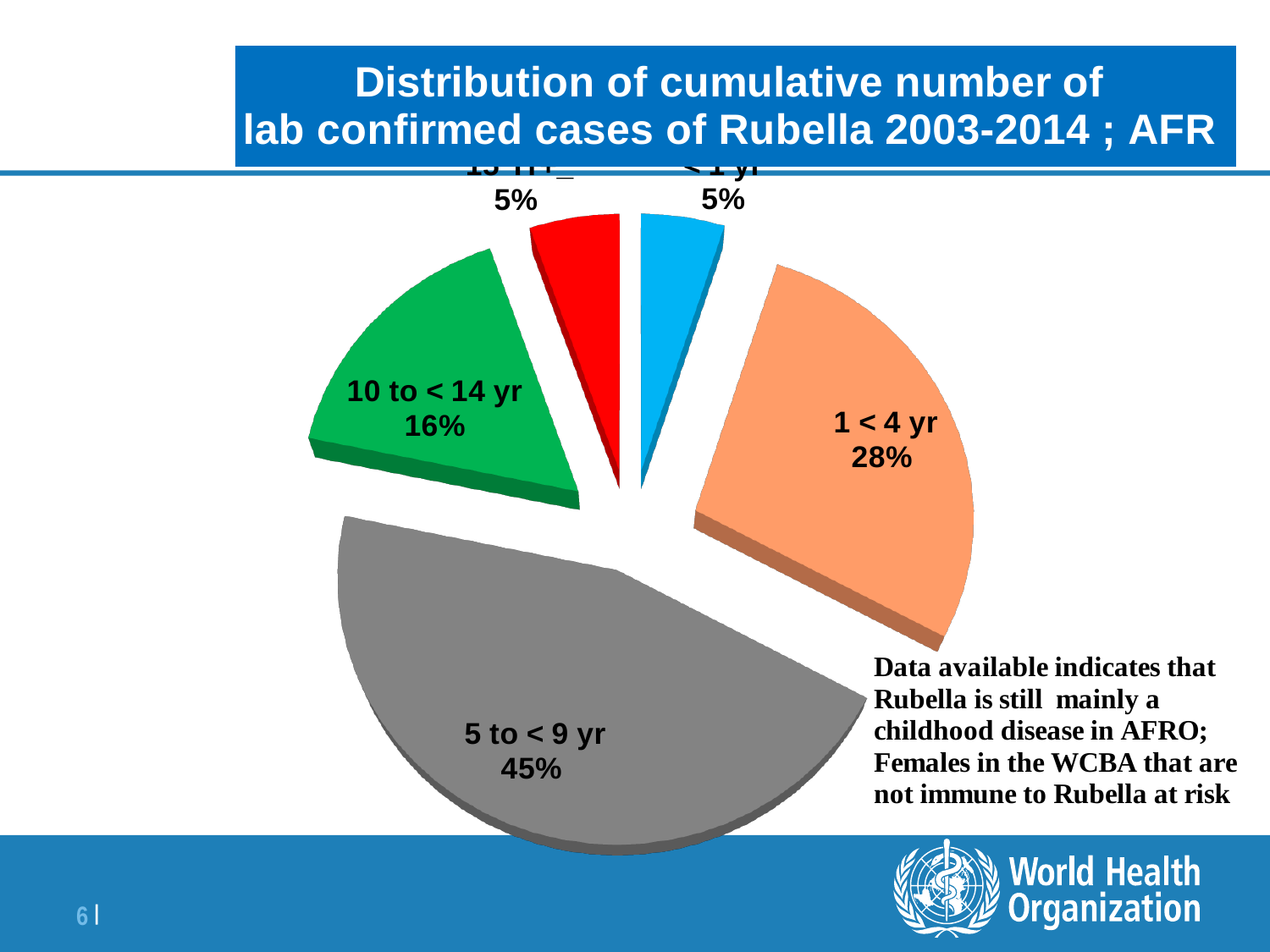
What share of lab confirmed Rubella cases is in the 5 to < 9 yr age group? 45% What share of lab confirmed Rubella cases is in the 10 to < 14 yr age group? 16% What share of lab confirmed Rubella cases is in the 1 < 4 yr age group? 28% What is the difference in percentage points between the 1 < 4 yr share and the 10 to < 14 yr share? 12 How many slices does the pie chart have? 5 Which is larger, the share for 10 to < 14 yr or the share for 1 < 4 yr? 1 < 4 yr How many slices in the pie chart are labelled 5%? 2 Which age group has the largest share of cases in the pie chart? 5 to < 9 yr What is the title of the chart on the slide? Distribution of cumulative number of lab confirmed cases of Rubella 2003-2014 ; AFR What colour is the slice for the 5 to < 9 yr age group? grey What kind of chart is shown on the slide? pie chart What is the difference in percentage points between the 5 to < 9 yr share and the 1 < 4 yr share? 17